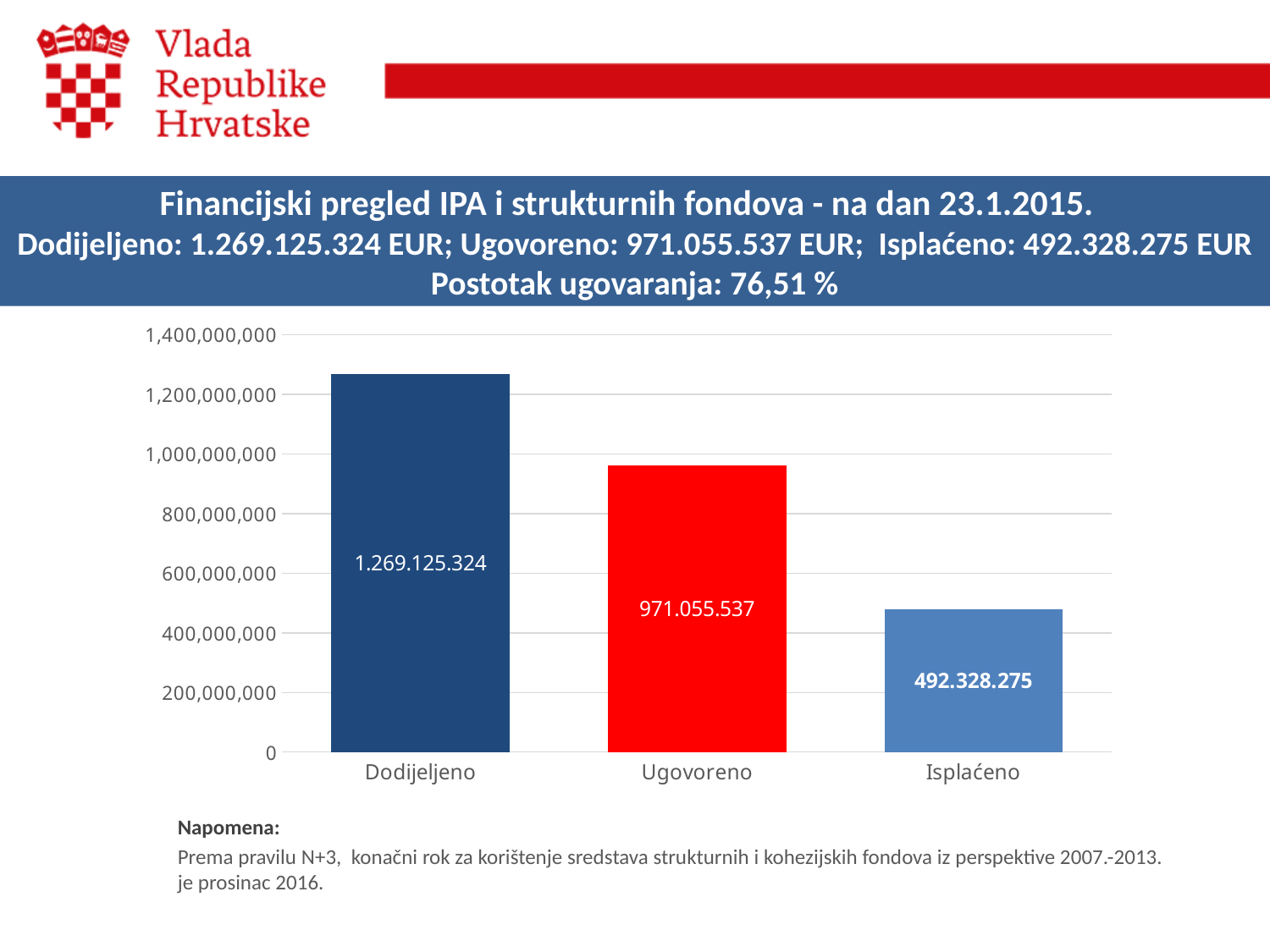
What kind of chart is shown on the slide? bar chart Do the values rise or fall from left to right along the x axis? fall Which category has the lowest value? Isplaćeno What is the value shown for Dodijeljeno? 1.269.125.324 What is the difference between the values for Dodijeljeno and Ugovoreno? 298.069.787 What is the value shown for Ugovoreno? 971.055.537 What is the difference between the values for Ugovoreno and Isplaćeno? 478.727.262 How many categories are shown on the x axis? 3 Which is larger, the value for Ugovoreno or the value for Isplaćeno? Ugovoreno Is the value for Isplaćeno greater or less than 600,000,000? less What is the value shown for Isplaćeno? 492.328.275 Which category has the highest value? Dodijeljeno